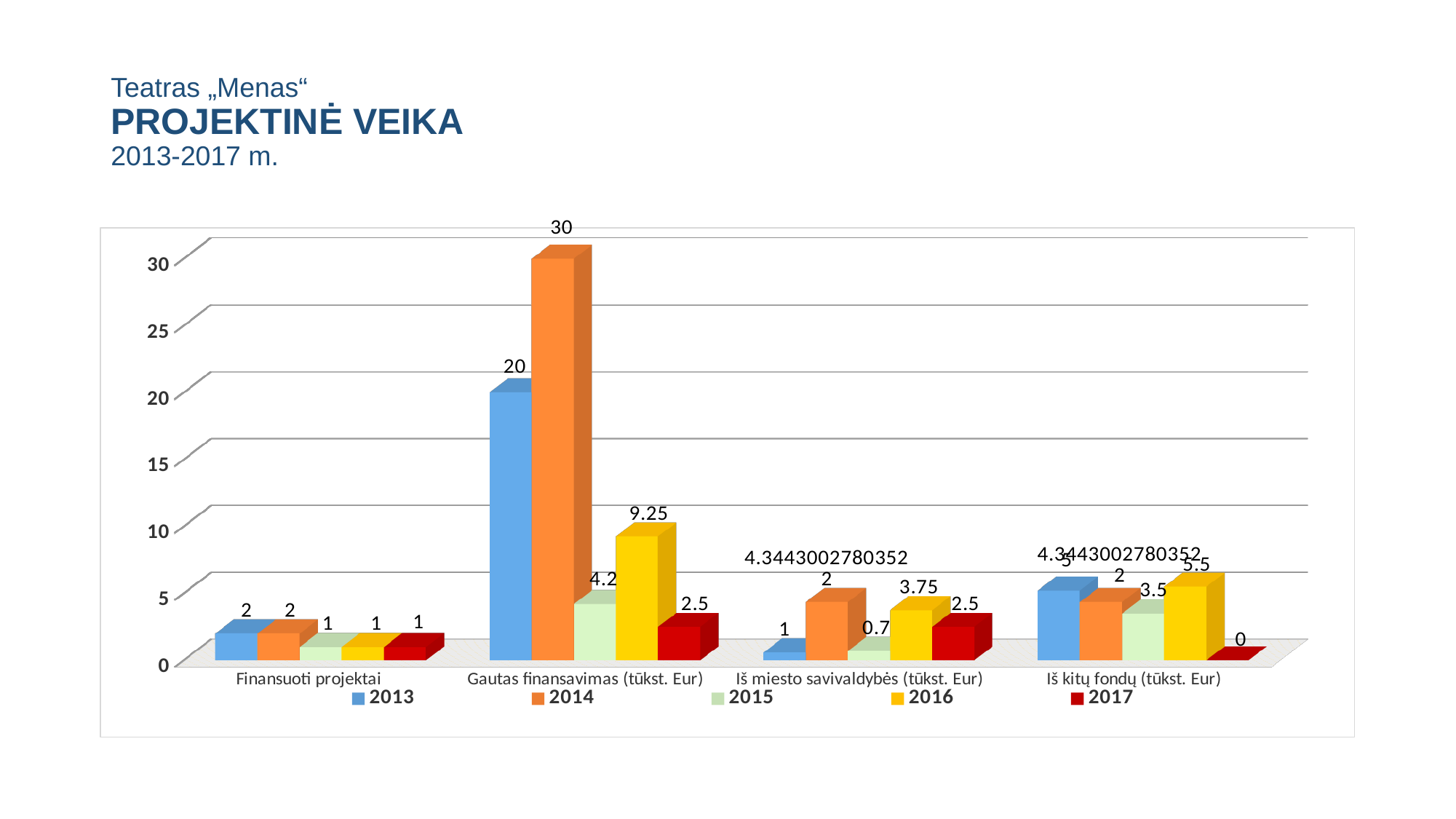
In the "Gautas finansavimas (tūkst. Eur)" category, how much larger is the 2014 value than the 2013 value? 10 Which year has the lowest value in the "Iš kitų fondų (tūkst. Eur)" category? 2017 What is the value for 2017 in the "Iš kitų fondų (tūkst. Eur)" category? 0 What is the value for 2016 in the "Gautas finansavimas (tūkst. Eur)" category? 9.25 What kind of chart is shown on the slide? Bar chart What is the value for 2015 in the "Iš miesto savivaldybės (tūkst. Eur)" category? 0.7 What is the value for 2014 in the "Gautas finansavimas (tūkst. Eur)" category? 30 In the "Iš miesto savivaldybės (tūkst. Eur)" category, which is larger: the value for 2016 or for 2017? 2016 Which year has the highest value in the "Gautas finansavimas (tūkst. Eur)" category? 2014 How many categories are shown on the x axis? 4 How many series does the legend list? 5 What is the value for 2016 in the "Iš kitų fondų (tūkst. Eur)" category? 5.5